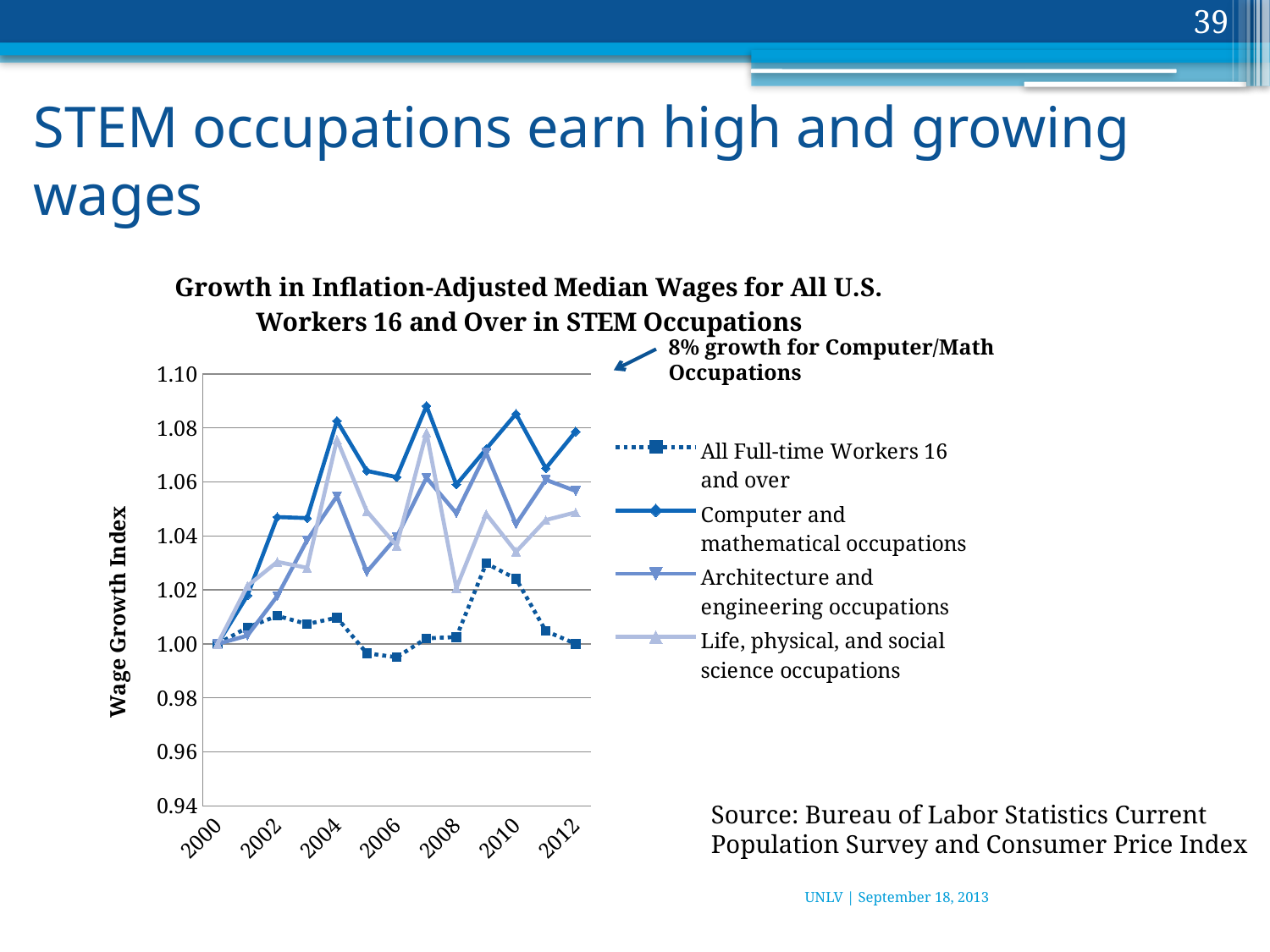
Which series has the highest value in 2012? Computer and mathematical occupations In 2004, which is larger: the value for Computer and mathematical occupations or the value for All Full-time Workers 16 and over? Computer and mathematical occupations Is the value for Architecture and engineering occupations in 2005 greater or less than 1.04? less Does the value for All Full-time Workers 16 and over rise or fall from 2009 to 2012? fall What is the label on the vertical axis of the chart? Wage Growth Index How many series does the legend list? 4 Is the value for All Full-time Workers 16 and over in 2009 greater or less than 1.02? greater Which series has the lowest value in 2012? All Full-time Workers 16 and over What is the title of the chart? Growth in Inflation-Adjusted Median Wages for All U.S. Workers 16 and Over in STEM Occupations Is the value for Life, physical, and social science occupations in 2012 greater or less than 1.04? greater What kind of chart is shown on the slide? line chart